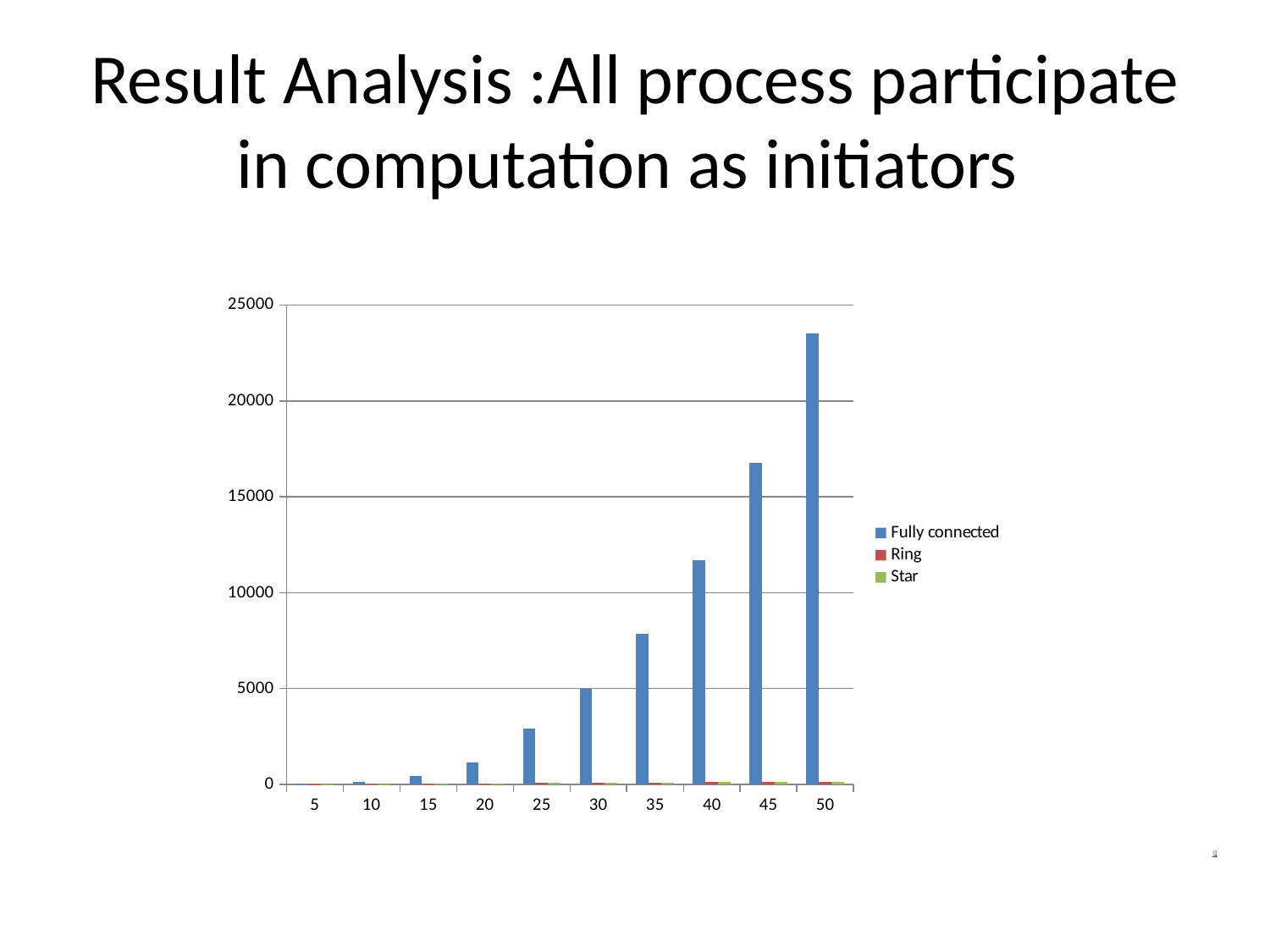
Which category has the highest value for the Fully connected series? 50 Is the Fully connected value at 30 greater or less than 10000? less How many categories are shown on the x axis? 10 Which series is shown in blue in the legend? Fully connected What kind of chart is shown on the slide? bar chart Which is larger, the Fully connected value at 35 or at 45? 45 How many series does the legend list? 3 Is the Fully connected value at 50 greater or less than 20000? greater Is the Fully connected value at 25 greater or less than 5000? less Do the Fully connected values rise or fall as the x axis goes from 5 to 50? rise